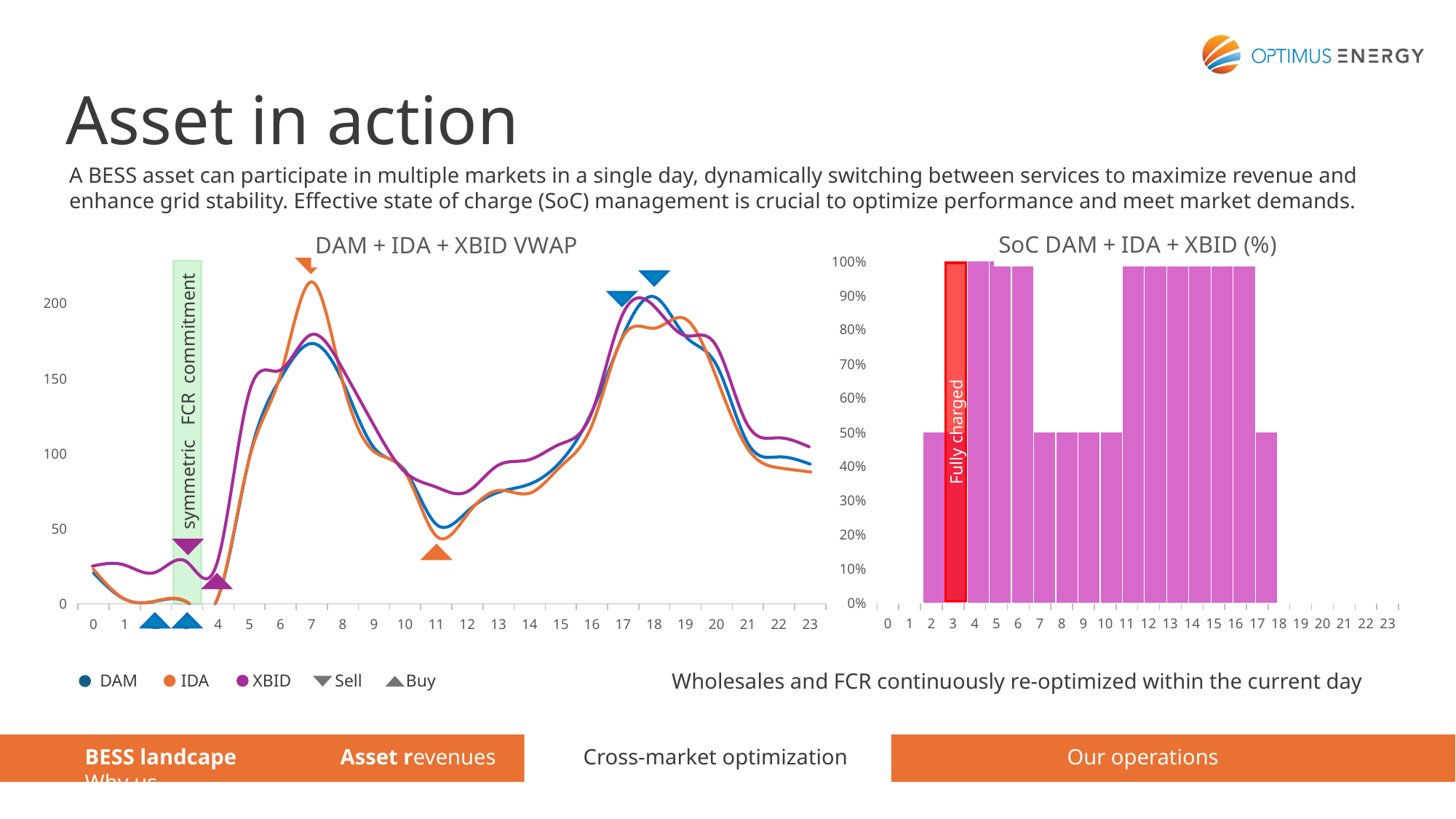
In the 'DAM + IDA + XBID VWAP' chart, is the XBID value at hour 1 greater or less than 50? less How many entries does the legend of the 'DAM + IDA + XBID VWAP' chart list? 5 In the 'DAM + IDA + XBID VWAP' chart, is the DAM value at hour 11 greater or less than 100? less In the 'SoC DAM + IDA + XBID (%)' chart, which is larger, the state of charge at hour 6 or at hour 8? hour 6 In the 'SoC DAM + IDA + XBID (%)' chart, what is the state of charge at hour 4? 100% In the 'DAM + IDA + XBID VWAP' chart, is the IDA value at hour 7 greater or less than 200? greater In the 'DAM + IDA + XBID VWAP' chart, which three markets are plotted as lines? DAM, IDA, XBID What kind of chart is the 'DAM + IDA + XBID VWAP' chart? line chart In the 'SoC DAM + IDA + XBID (%)' chart, what is the state of charge at hour 7? 50% What kind of chart is the 'SoC DAM + IDA + XBID (%)' chart? bar chart In the 'DAM + IDA + XBID VWAP' chart, what is the label on the green shaded band around hours 2-3? symmetric FCR commitment